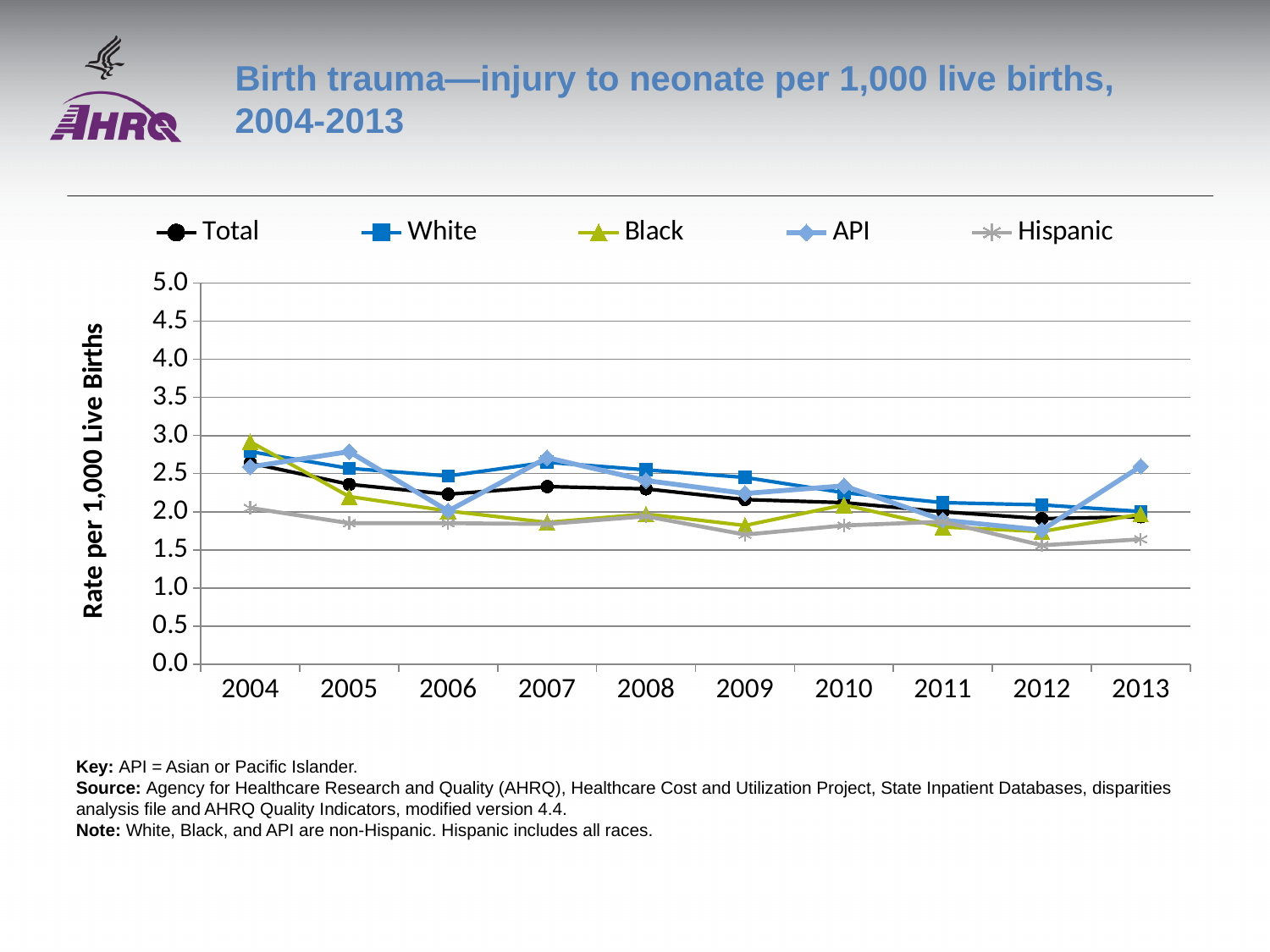
Is the value for Hispanic in 2012 greater or less than 2.0? less How many series does the legend list? 5 Which series has the lowest value in 2012? Hispanic Is the value for Black in 2004 greater or less than 2.5? greater How many years are plotted along the x axis? 10 Which series has the highest value in 2013? API Does the Total line generally rise or fall from 2004 to 2013? fall Is the value for API in 2013 greater or less than 2.0? greater What kind of chart is shown on the slide? line chart In 2008, which is larger, the value for White or the value for Hispanic? White What is the title of the y axis? Rate per 1,000 Live Births